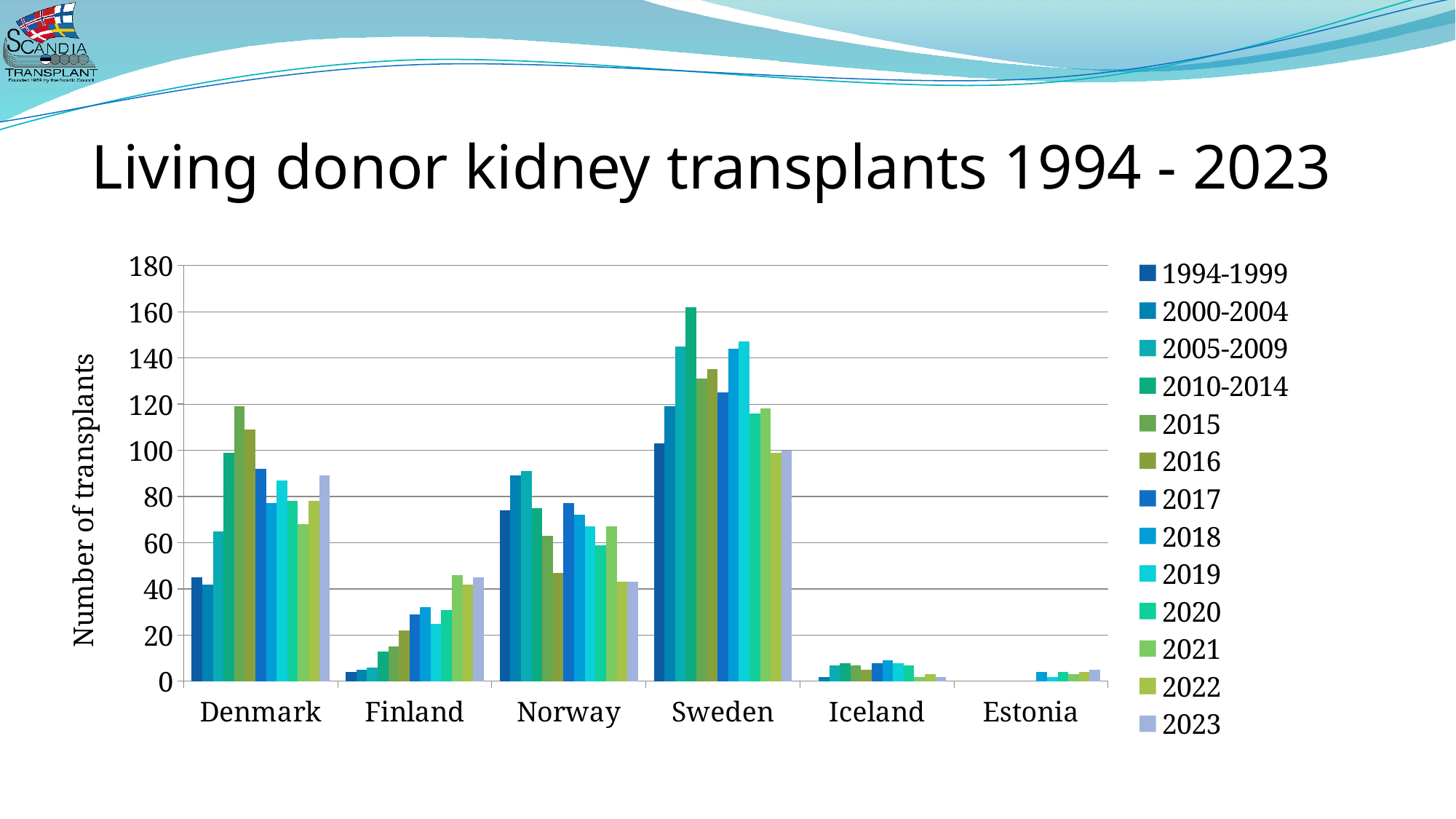
Is the value for Denmark in 2015 greater or less than 100? greater How many countries are shown on the x axis of the chart? 6 Is the value for Sweden in 2010-2014 greater or less than 140? greater How many series (time periods) does the legend list? 13 Is the value for Finland in 2021 greater or less than 40? greater Which is larger for 2023: Denmark or Finland? Denmark What is the label on the y axis of the chart? Number of transplants What kind of chart is shown on the slide? bar chart For Norway, which is larger: the 2000-2004 bar or the 2023 bar? 2000-2004 Which country has the tallest bar in the chart? Sweden Which country has the lowest bars overall in the chart? Estonia